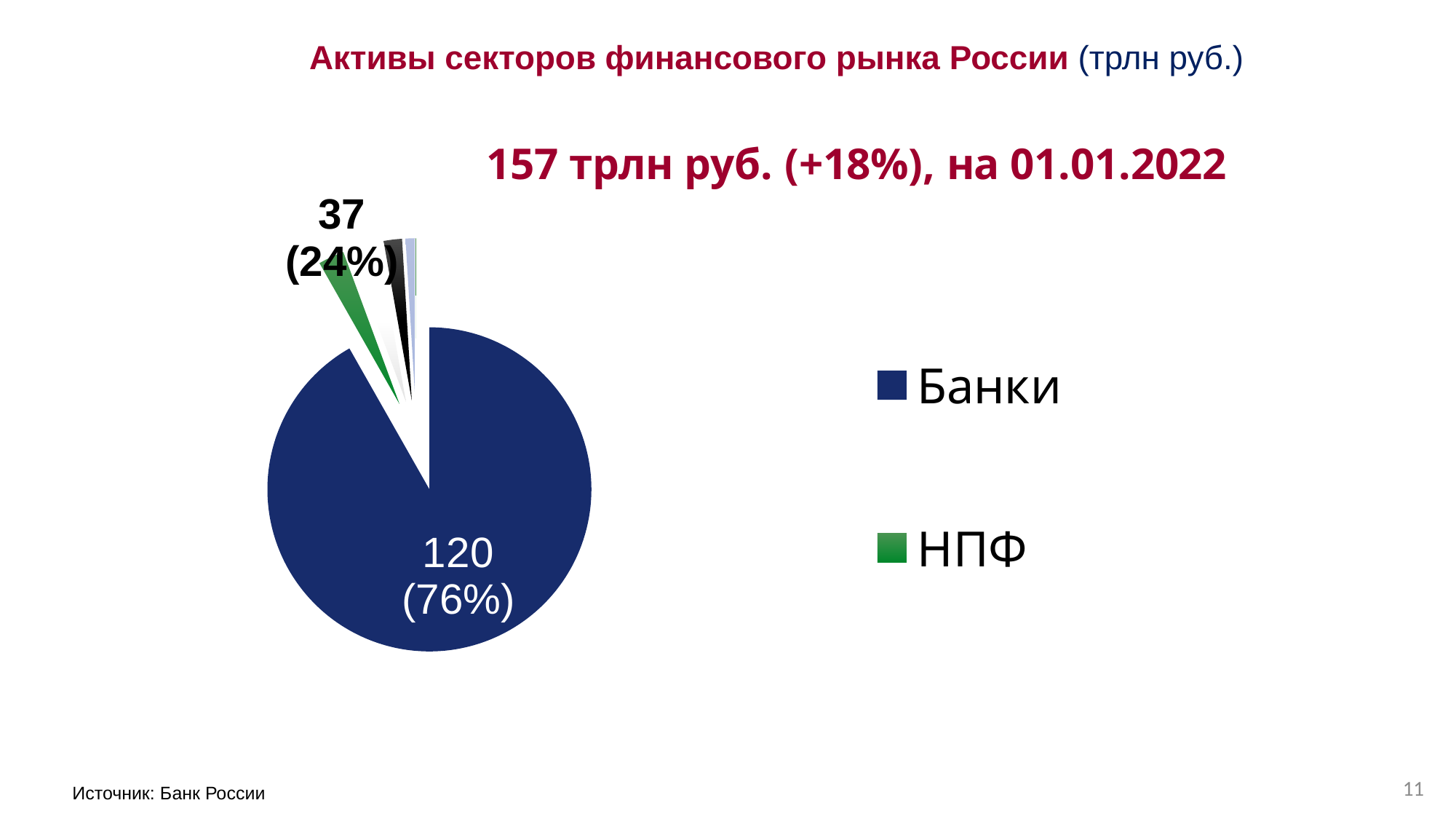
What percentage share is printed for the Банки slice? 76% What growth percentage is stated in the headline above the chart? +18% What percentage share is printed next to the small exploded slices? 24% What kind of chart is shown on the slide? Pie chart Which category has the largest slice in the pie chart? Банки How many entries does the legend list? 2 What total value is stated in the headline above the chart? 157 трлн руб. What is the difference between the 120 value and the 37 value shown on the pie chart? 83 What value is printed next to the small exploded slices of the pie chart? 37 What value is printed on the Банки slice of the pie chart? 120 Which slice is larger, Банки or НПФ? Банки What is the title of the chart? 157 трлн руб. (+18%), на 01.01.2022